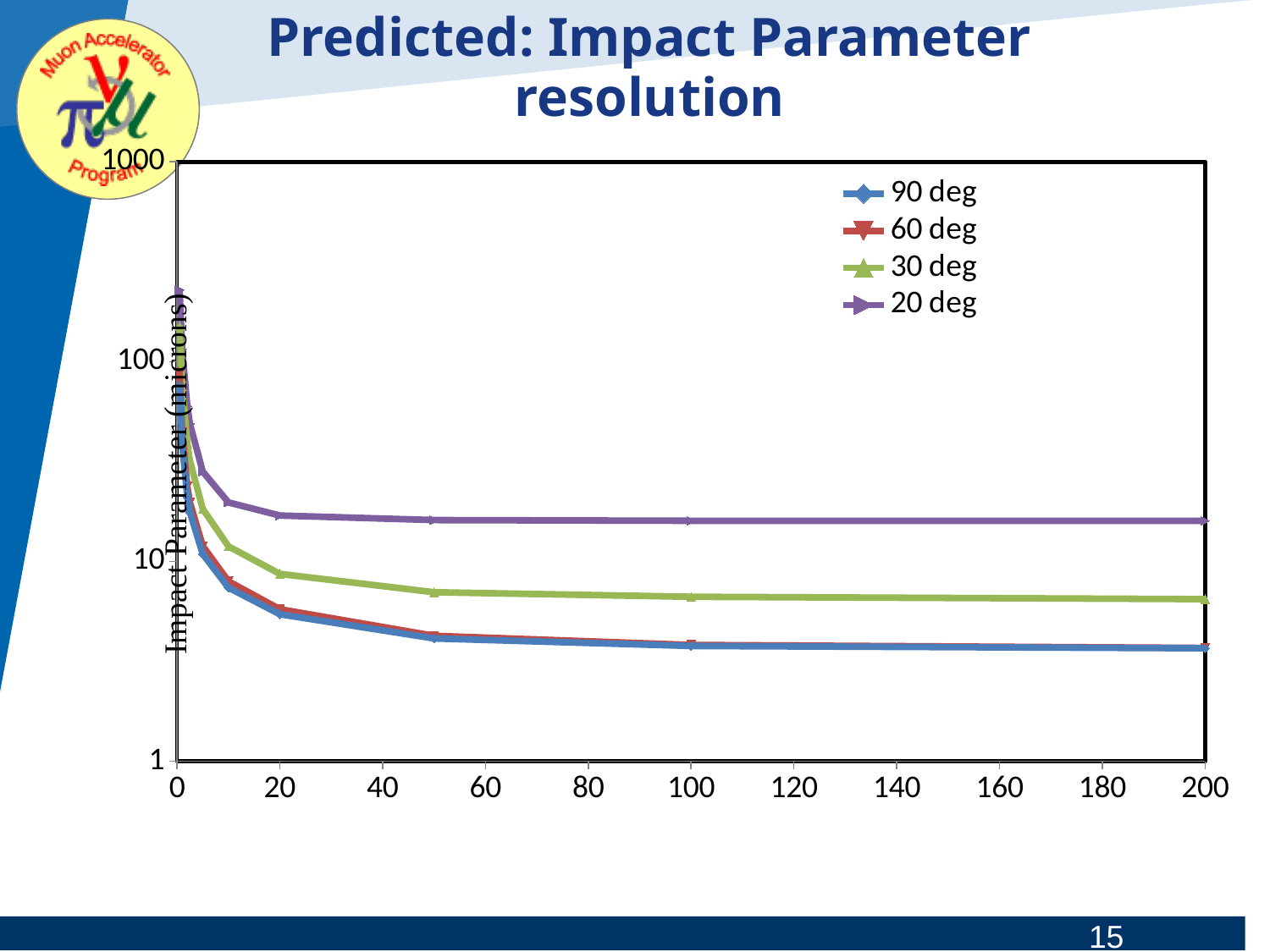
Which series has the highest value at x = 200? 20 deg Is the value of the 20 deg series at x = 100 greater or less than 100? less Is the value of the 90 deg series at x = 100 greater or less than 10? less Is the value of the 30 deg series at x = 200 greater or less than 10? less What is the label of the y axis? Impact Parameter (microns) At x = 50, which series has the larger value, 30 deg or 90 deg? 30 deg What kind of chart is shown on the slide? line chart How many series does the legend list? 4 At x = 100, which series has the larger value, 20 deg or 30 deg? 20 deg Do the values of the 30 deg series rise or fall as x increases from 0 to 200? fall What is the title of the chart? Predicted: Impact Parameter resolution